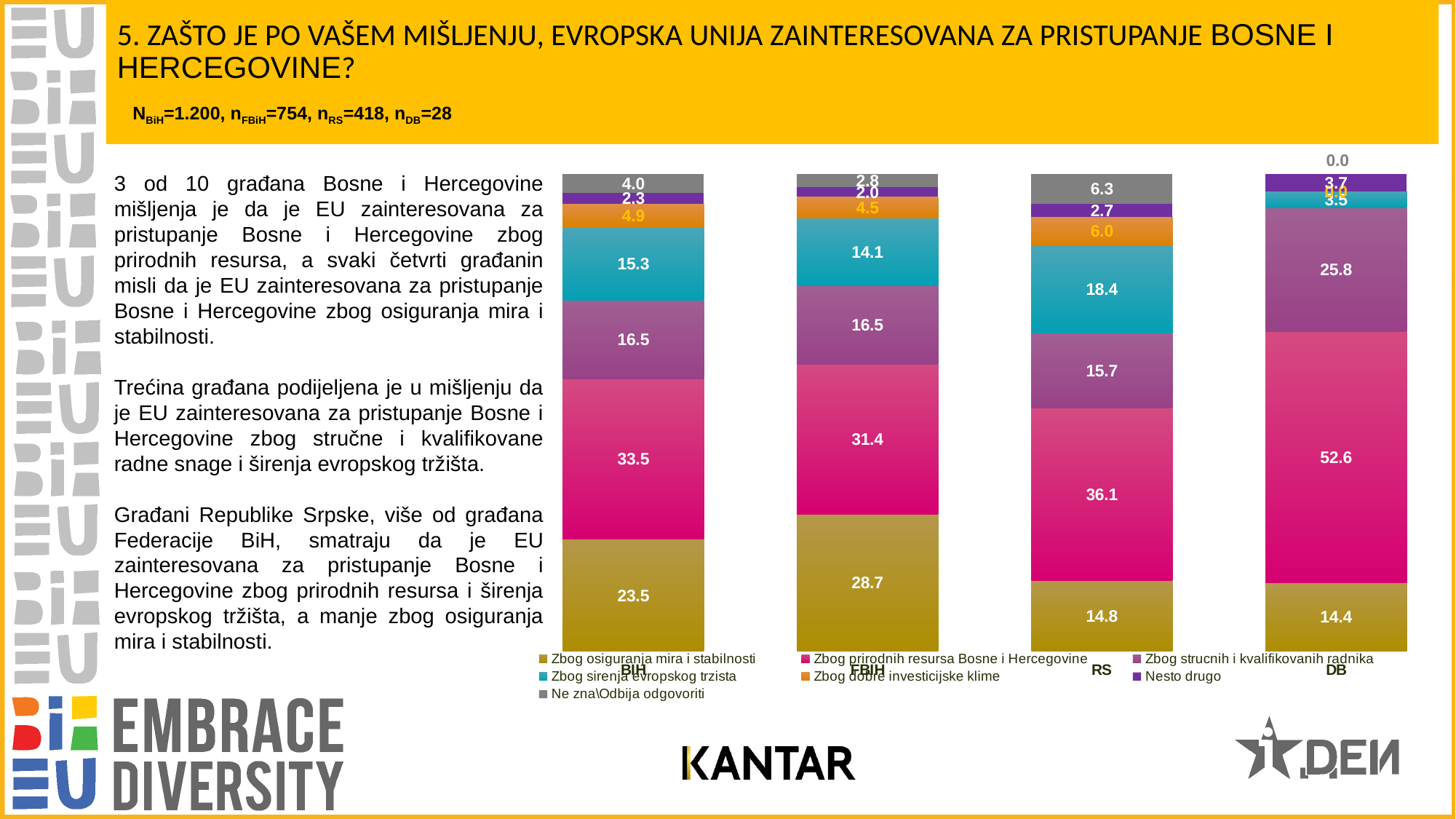
How many series does the chart legend list? 7 Which category has the lowest value for 'Zbog osiguranja mira i stabilnosti'? DB Which category has the highest value for 'Zbog prirodnih resursa Bosne i Hercegovine'? DB What is the difference between the RS and FBIH values for 'Zbog prirodnih resursa Bosne i Hercegovine'? 4.7 What kind of chart is shown on the slide? Stacked bar chart What is the total of the FBIH stacked bar? 100.0 What is the value for 'Zbog sirenja evropskog trzista' in the RS bar? 18.4 What is the value for 'Zbog prirodnih resursa Bosne i Hercegovine' in the DB bar? 52.6 What is the value for 'Ne zna\Odbija odgovoriti' in the FBIH bar? 2.8 Which has the larger value for 'Zbog osiguranja mira i stabilnosti', BIH or FBIH? FBIH How many categories (groups) are shown along the x axis of the chart? 4 What is the value for 'Zbog prirodnih resursa Bosne i Hercegovine' in the BIH bar? 33.5